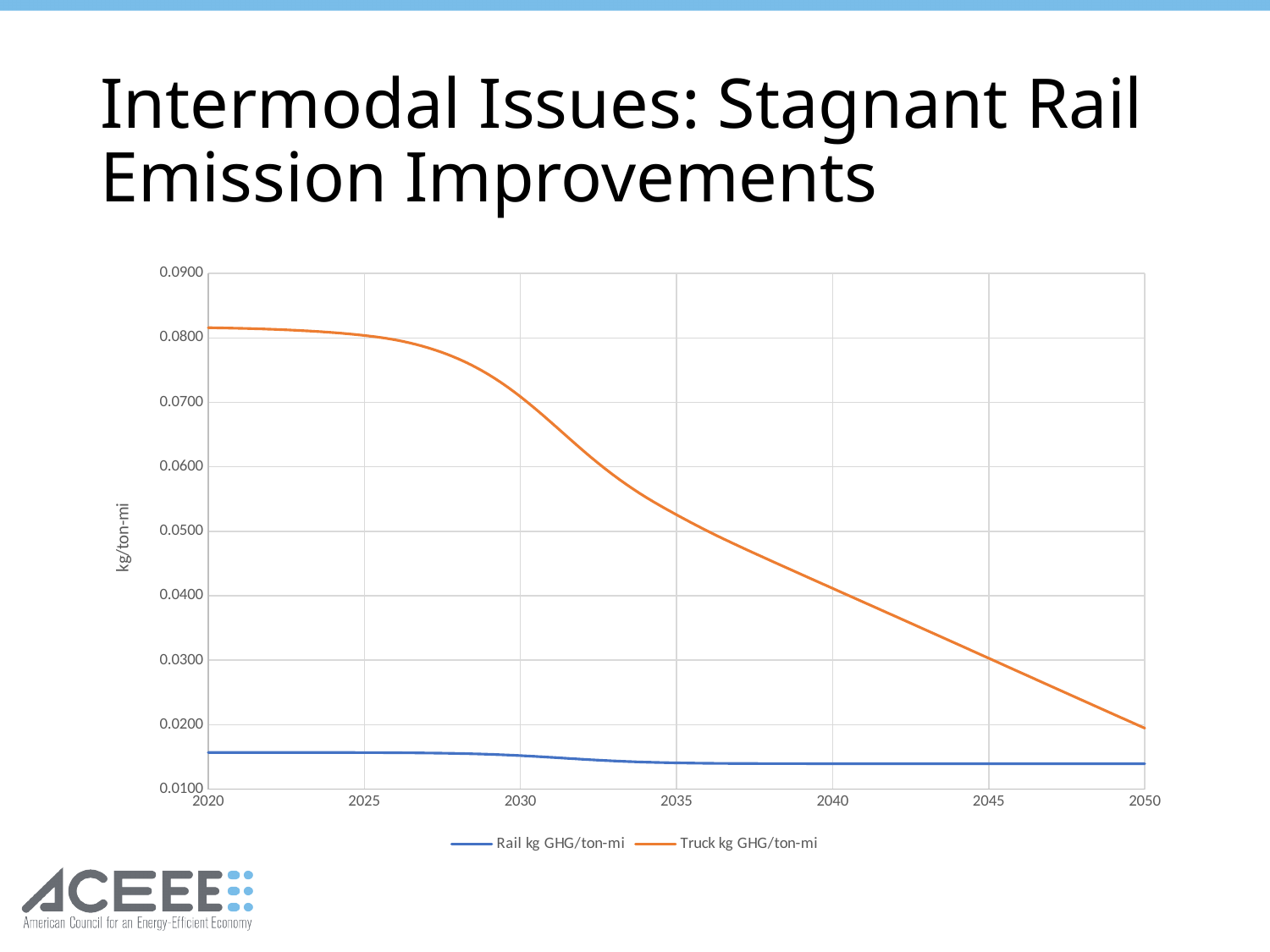
Is the value for Truck kg GHG/ton-mi in 2020 greater or less than 0.0700? greater Which series has the higher value in 2020, Rail kg GHG/ton-mi or Truck kg GHG/ton-mi? Truck kg GHG/ton-mi What kind of chart is shown on the slide? line chart Is the value for Truck kg GHG/ton-mi in 2050 greater or less than 0.0300? less Is the value for Truck kg GHG/ton-mi in 2040 greater or less than 0.0300? greater What are the two series named in the legend? Rail kg GHG/ton-mi and Truck kg GHG/ton-mi What is the title of the y axis? kg/ton-mi Does the Truck kg GHG/ton-mi line rise or fall from 2020 to 2050? fall How many series does the legend list? 2 Which series has the higher value in 2050, Rail kg GHG/ton-mi or Truck kg GHG/ton-mi? Truck kg GHG/ton-mi